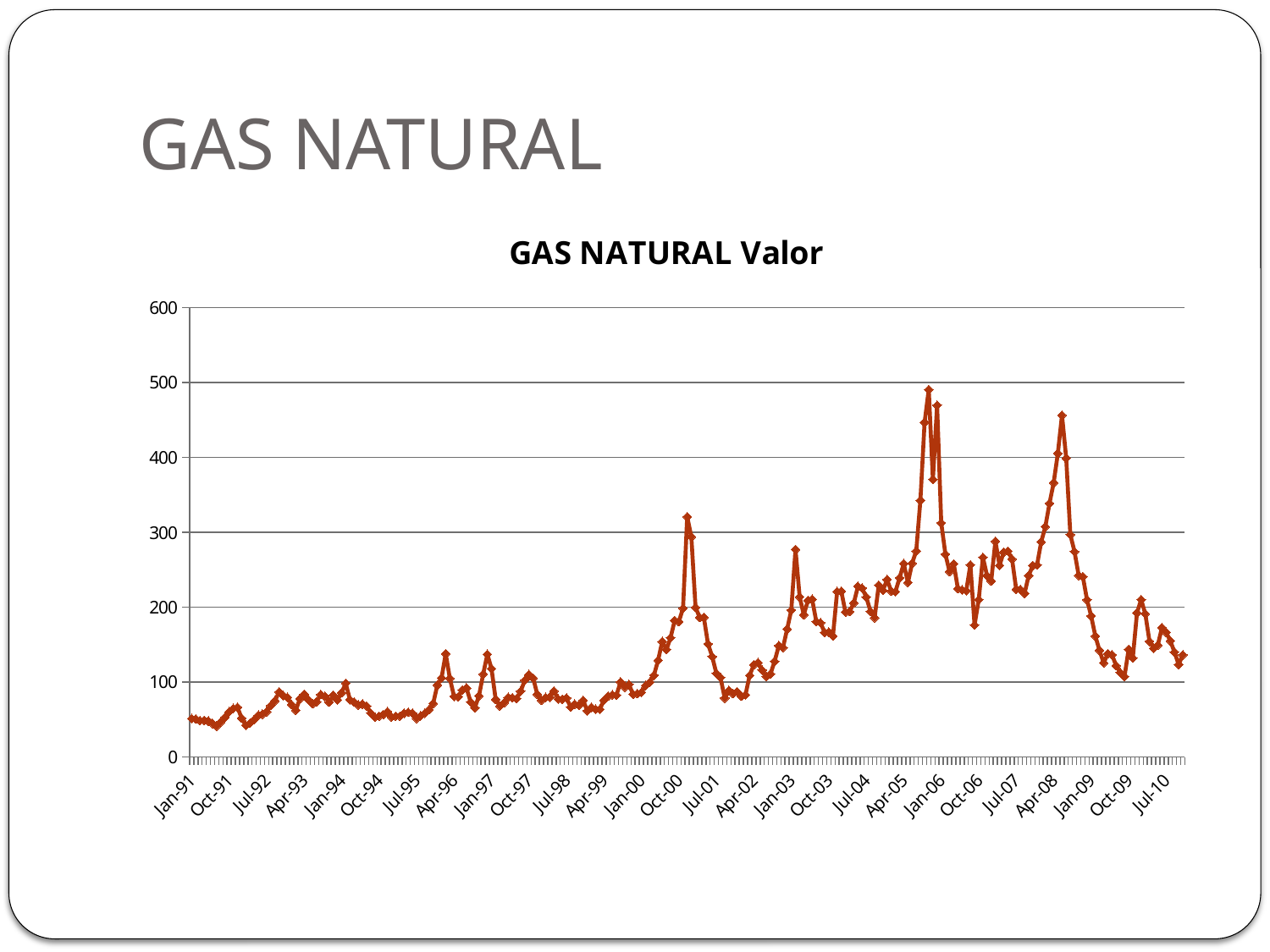
Which is larger, the value for Jan-06 or the value for Jan-91? Jan-06 What is the highest value shown on the y axis? 600 What is the title of the chart? GAS NATURAL Valor Is the value for Jul-10 greater or less than 200? less Is the value for Oct-09 greater or less than 200? less Is the value for Jan-91 greater or less than 100? less What kind of chart is shown on the slide? line chart Around which labeled date on the x axis does the highest value of the series occur? Jan-06 Overall, do the values rise or fall from Jan-91 to Jan-06? rise